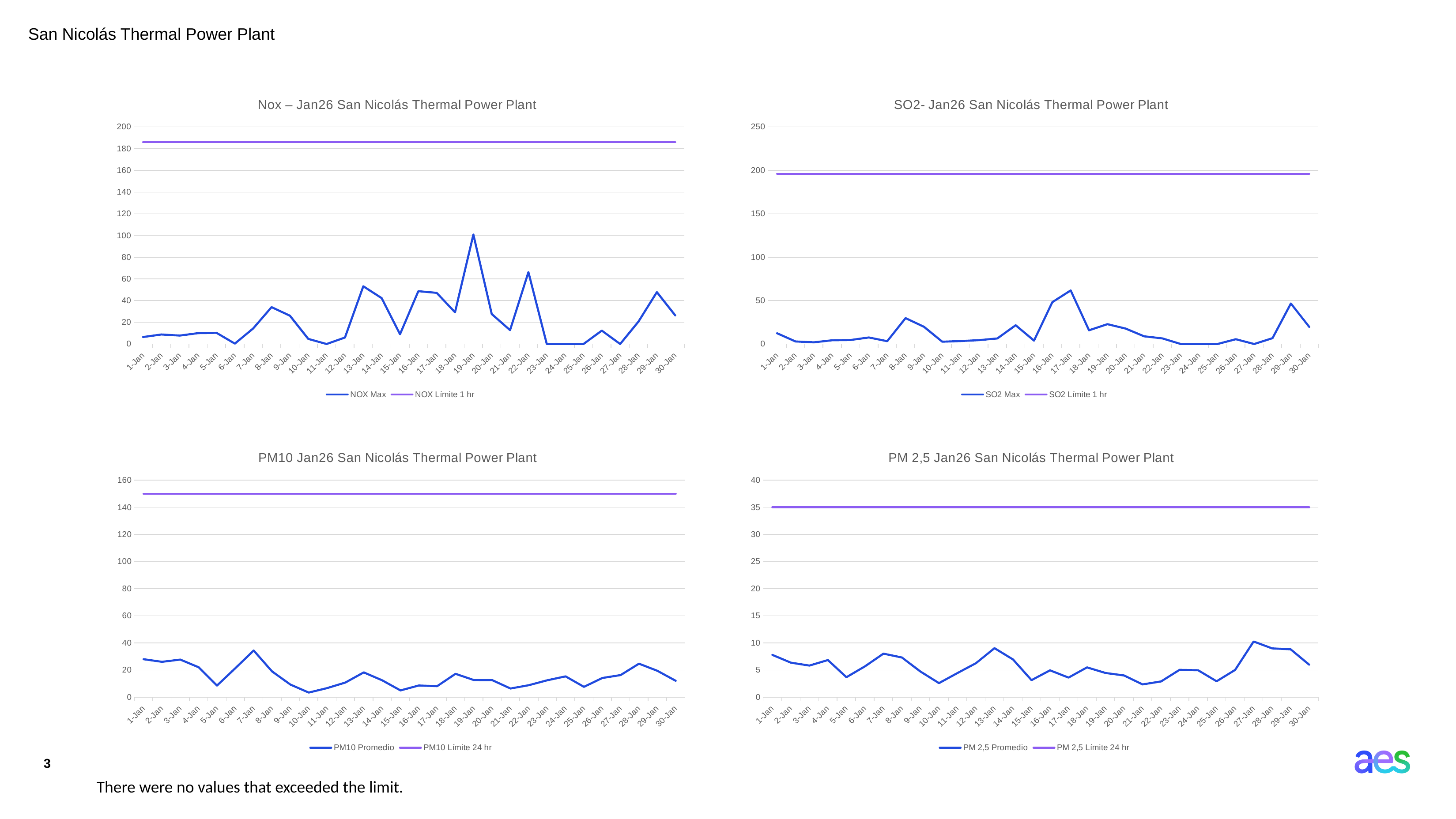
In the 'SO2- Jan26 San Nicolás Thermal Power Plant' chart, is the SO2 Max value for 17-Jan greater or less than 50? greater What are the two legend entries of the 'PM 2,5 Jan26 San Nicolás Thermal Power Plant' chart? PM 2,5 Promedio and PM 2,5 Límite 24 hr How many dates are plotted along the x axis of the 'PM10 Jan26 San Nicolás Thermal Power Plant' chart? 30 In the 'PM10 Jan26 San Nicolás Thermal Power Plant' chart, is the PM10 Límite 24 hr line greater or less than 140? greater In the 'PM 2,5 Jan26 San Nicolás Thermal Power Plant' chart, on which date is PM 2,5 Promedio highest? 27-Jan In the 'Nox – Jan26 San Nicolás Thermal Power Plant' chart, on which date is NOX Max highest? 19-Jan In the 'Nox – Jan26 San Nicolás Thermal Power Plant' chart, is the NOX Max value for 19-Jan greater or less than 80? greater How many series does the legend of the 'SO2- Jan26 San Nicolás Thermal Power Plant' chart list? 2 What kind of chart is the 'Nox – Jan26 San Nicolás Thermal Power Plant' chart? line chart In the 'SO2- Jan26 San Nicolás Thermal Power Plant' chart, on which date is SO2 Max highest? 17-Jan In the 'PM 2,5 Jan26 San Nicolás Thermal Power Plant' chart, what is the value of the PM 2,5 Límite 24 hr line? 35